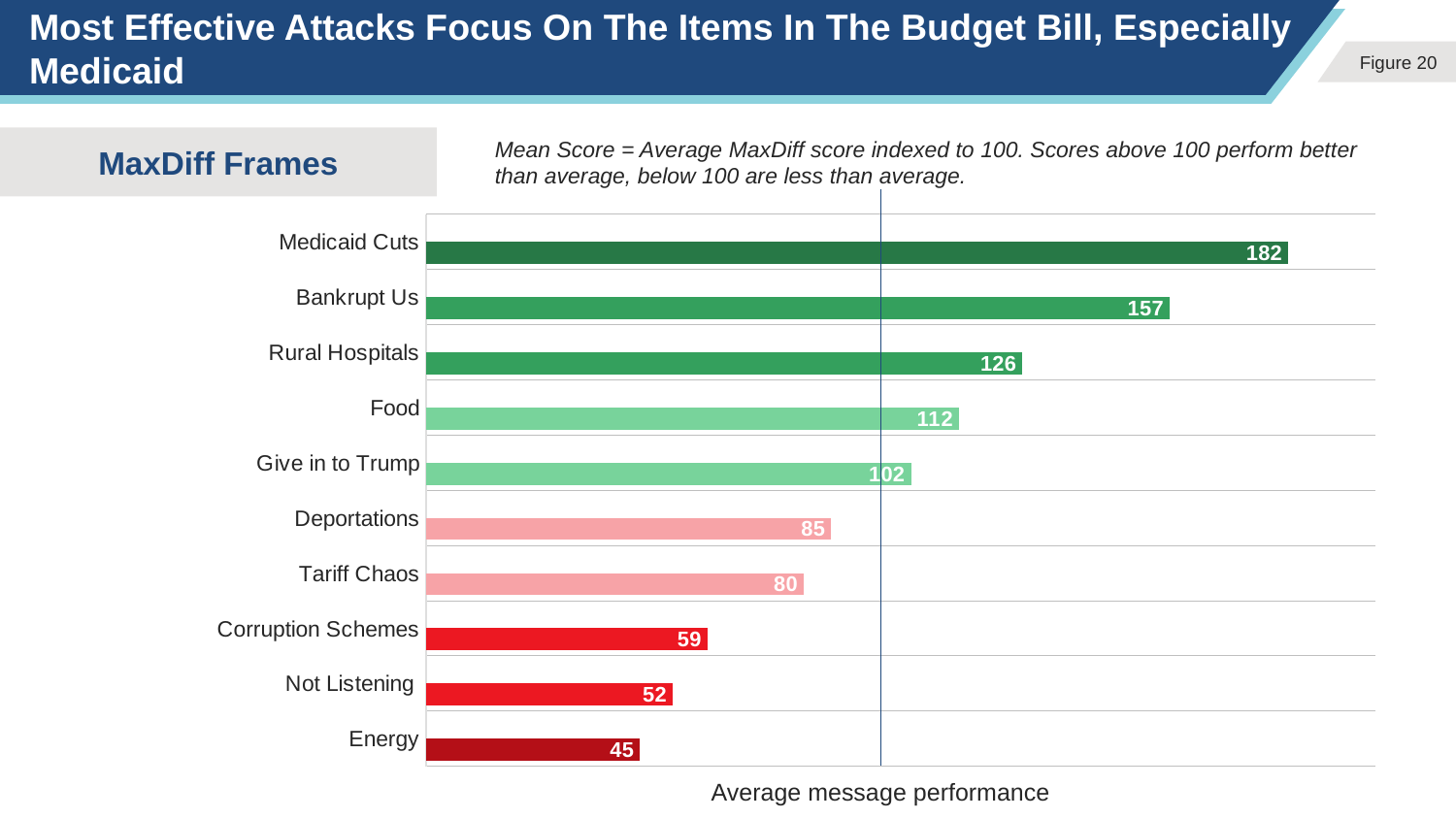
What kind of chart is shown on the slide? Bar chart How many categories are shown in the chart? 10 What is the difference between the values for Medicaid Cuts and Bankrupt Us? 25 Which category has the highest value? Medicaid Cuts What is the value for Tariff Chaos? 80 Which is larger, the value for Deportations or the value for Corruption Schemes? Deportations What is the x-axis label of the chart? Average message performance What is the difference between the values for Food and Energy? 67 Which category has the lowest value? Energy What is the value for Medicaid Cuts? 182 What is the value for Rural Hospitals? 126 What is the value for Not Listening? 52